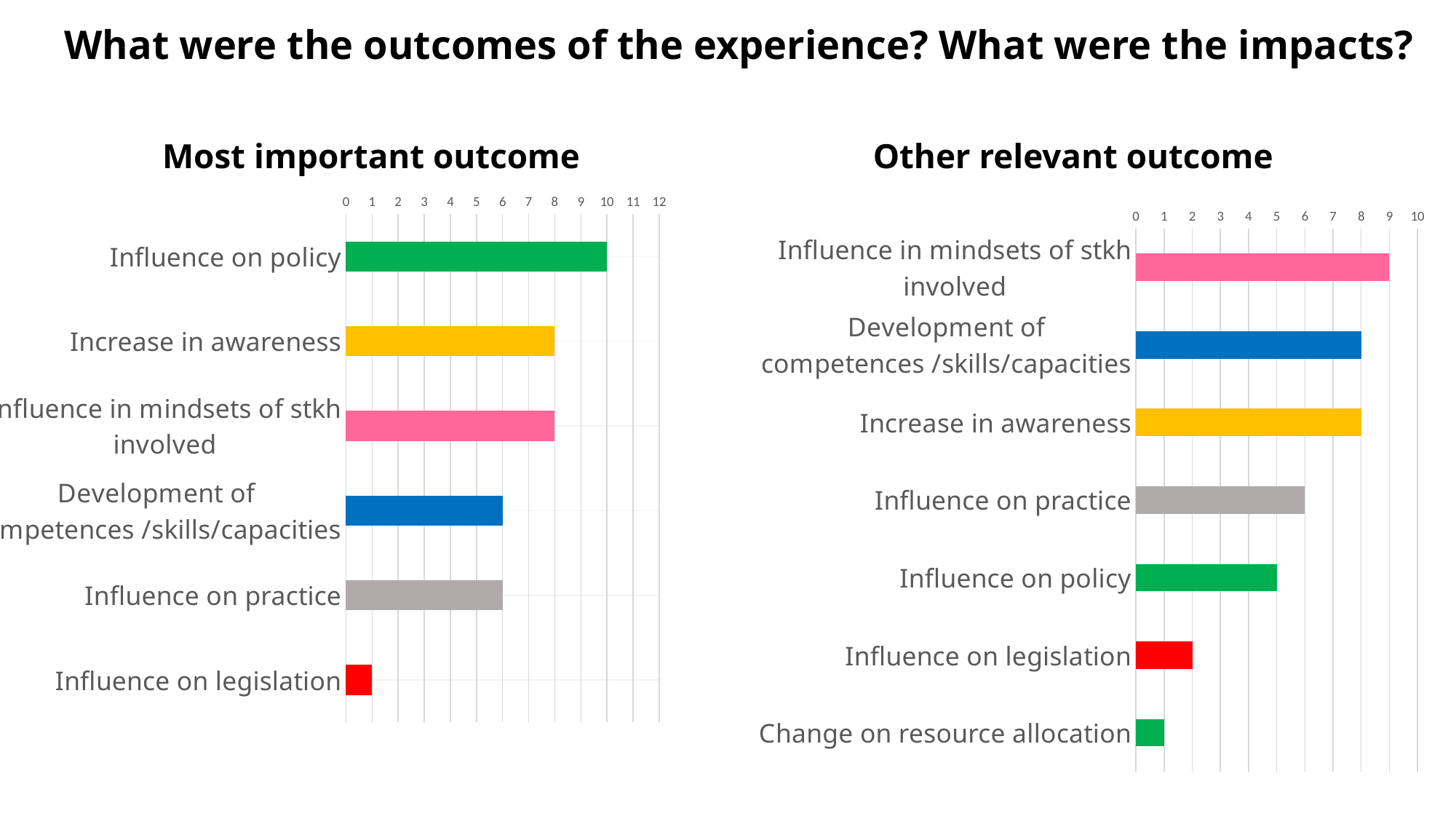
In the 'Most important outcome' chart, what is the value for Influence on policy? 10 In the 'Most important outcome' chart, how many categories are shown? 6 In the 'Other relevant outcome' chart, what is the value for Influence on policy? 5 In the 'Other relevant outcome' chart, what is the value for Change on resource allocation? 1 What type of chart is the 'Other relevant outcome' chart? Bar chart In the 'Most important outcome' chart, what colour is the bar for Influence on legislation? Red In the 'Most important outcome' chart, is the value for Increase in awareness greater or less than 6? greater In the 'Most important outcome' chart, what is the difference between Influence on policy and Influence on practice? 4 In the 'Other relevant outcome' chart, which is larger: Influence on practice or Influence on legislation? Influence on practice In the 'Most important outcome' chart, which category has the lowest value? Influence on legislation In the 'Other relevant outcome' chart, which category has the highest value? Influence in mindsets of stkh involved In the 'Other relevant outcome' chart, how many categories are shown? 7